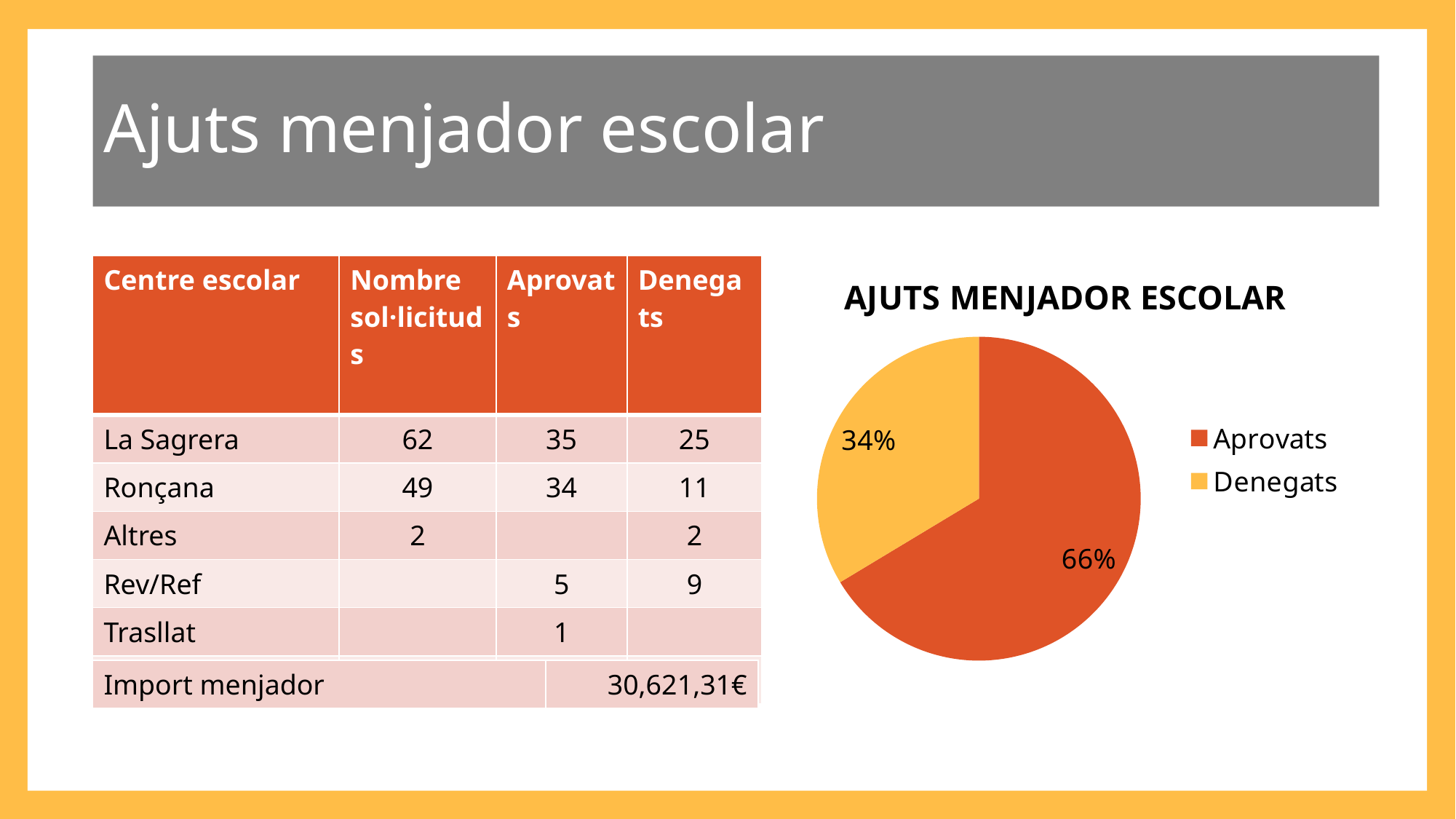
What is the title of the chart? AJUTS MENJADOR ESCOLAR Which is larger, the Aprovats slice or the Denegats slice? Aprovats How many entries does the chart legend list? 2 Is the share for Aprovats greater or less than 50%? greater What kind of chart is shown on the slide? pie chart Which slice of the pie is the smallest? Denegats How many slices does the pie chart have? 2 Which slice of the pie is the largest? Aprovats What share of the pie does Denegats represent? 34% What is the difference in percentage points between the Aprovats and Denegats slices? 32 What share of the pie does Aprovats represent? 66% What colour is the Denegats slice in the pie chart? yellow